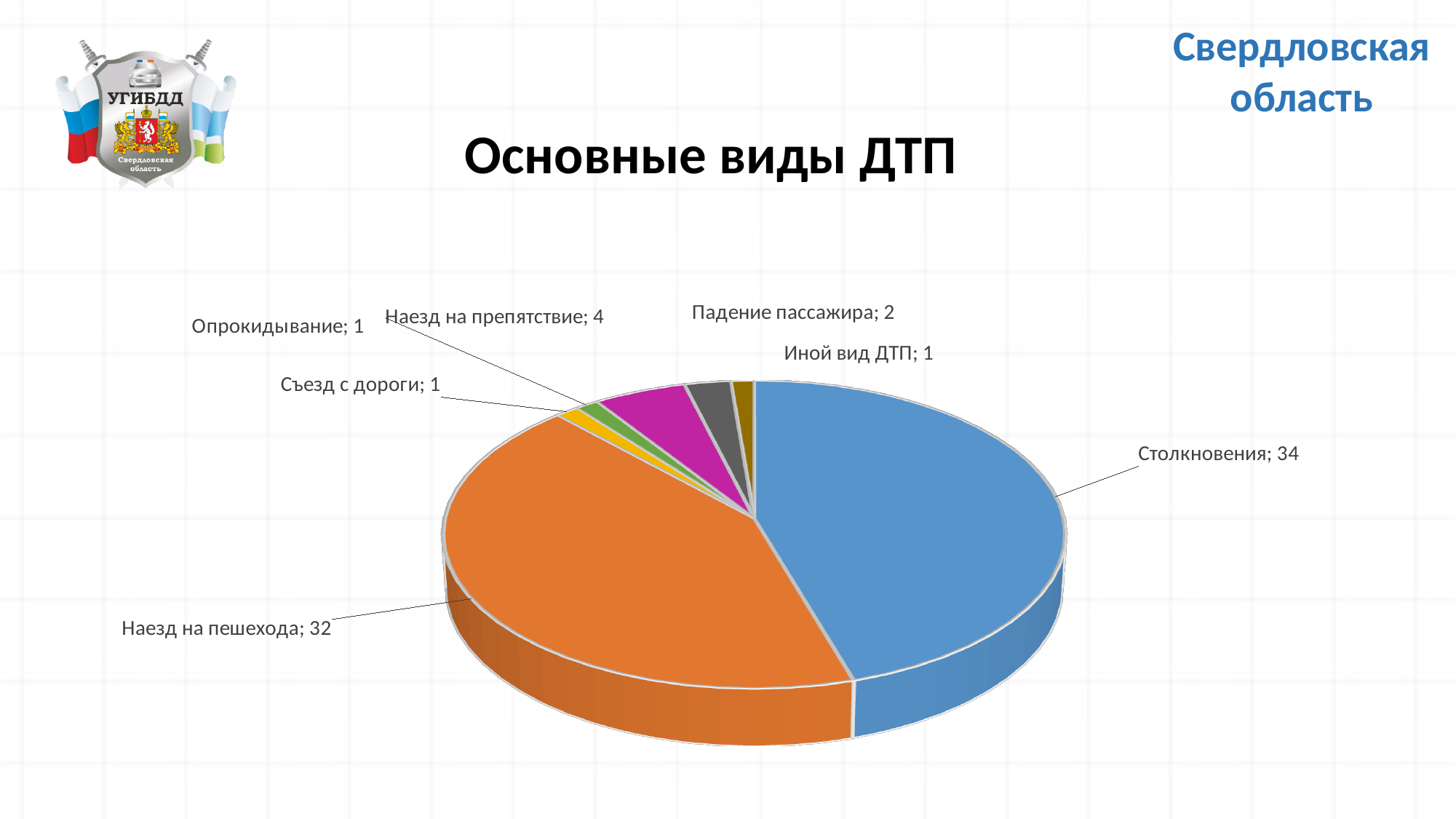
What is the total of all the values in the pie chart? 75 What type of chart is shown on the slide? Pie chart What is the value for Наезд на препятствие? 4 What is the value for Наезд на пешехода? 32 What is the value for Столкновения? 34 Which category has the highest value? Столкновения What is the value for Падение пассажира? 2 What is the difference between Столкновения and Наезд на пешехода? 2 How many categories does the pie chart have? 7 What is the title of the chart? Основные виды ДТП Which categories share the lowest value? Иной вид ДТП, Опрокидывание, Съезд с дороги Which is larger, Наезд на препятствие or Падение пассажира? Наезд на препятствие